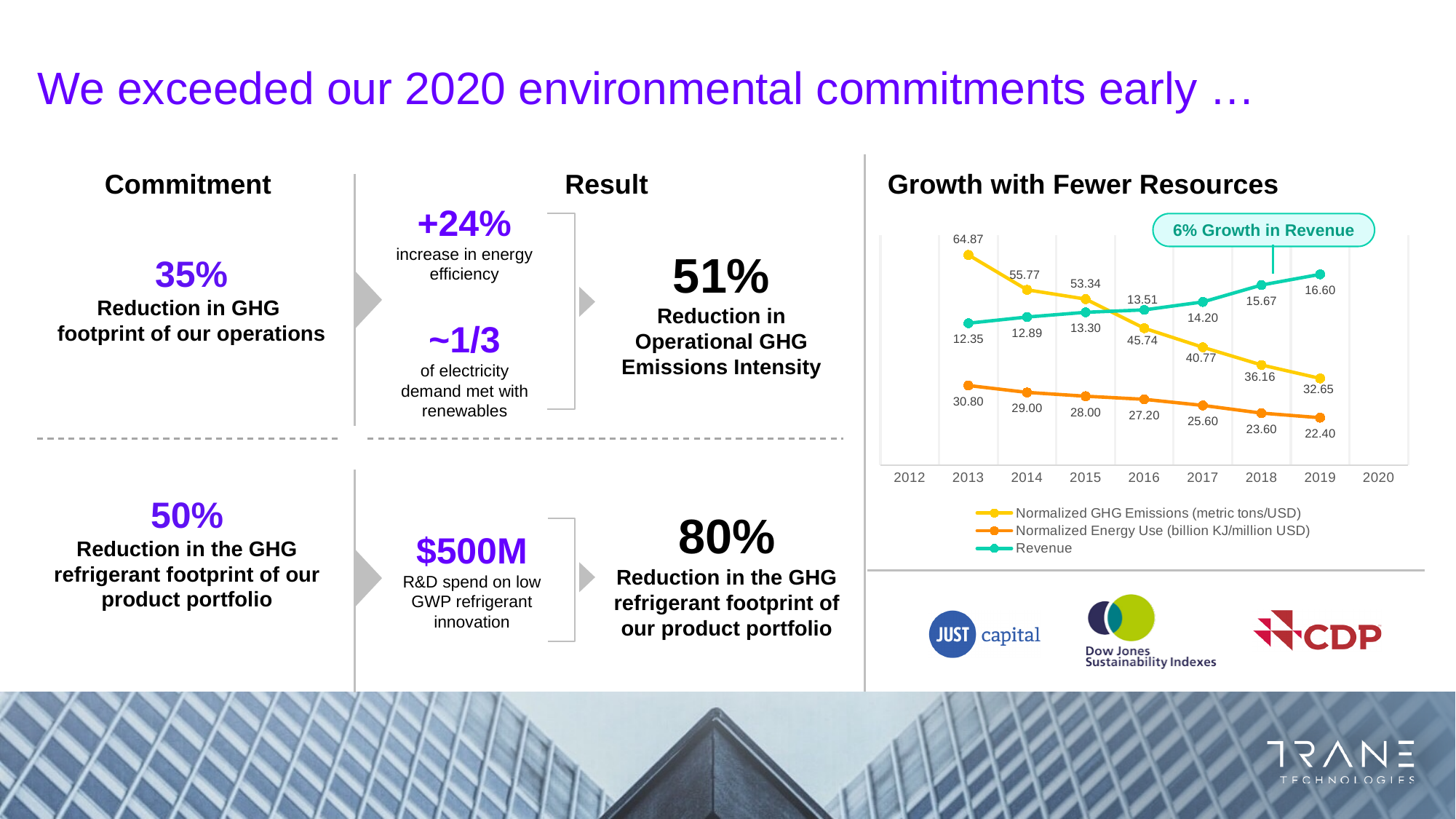
What is the Normalized Energy Use value for 2016? 27.20 In which year is Normalized GHG Emissions lowest? 2019 What is the difference between the Normalized GHG Emissions values for 2013 and 2019? 32.22 How many years have data points plotted for each series? 7 What kind of chart is shown under 'Growth with Fewer Resources'? Line chart In which year is Revenue highest? 2019 What is the Normalized GHG Emissions value for 2013? 64.87 How many series does the legend list? 3 What is the Revenue value for 2019? 16.60 Does Normalized Energy Use rise or fall from 2013 to 2019? Fall What is the title of the chart? Growth with Fewer Resources Which is larger in 2017: Normalized GHG Emissions or Normalized Energy Use? Normalized GHG Emissions